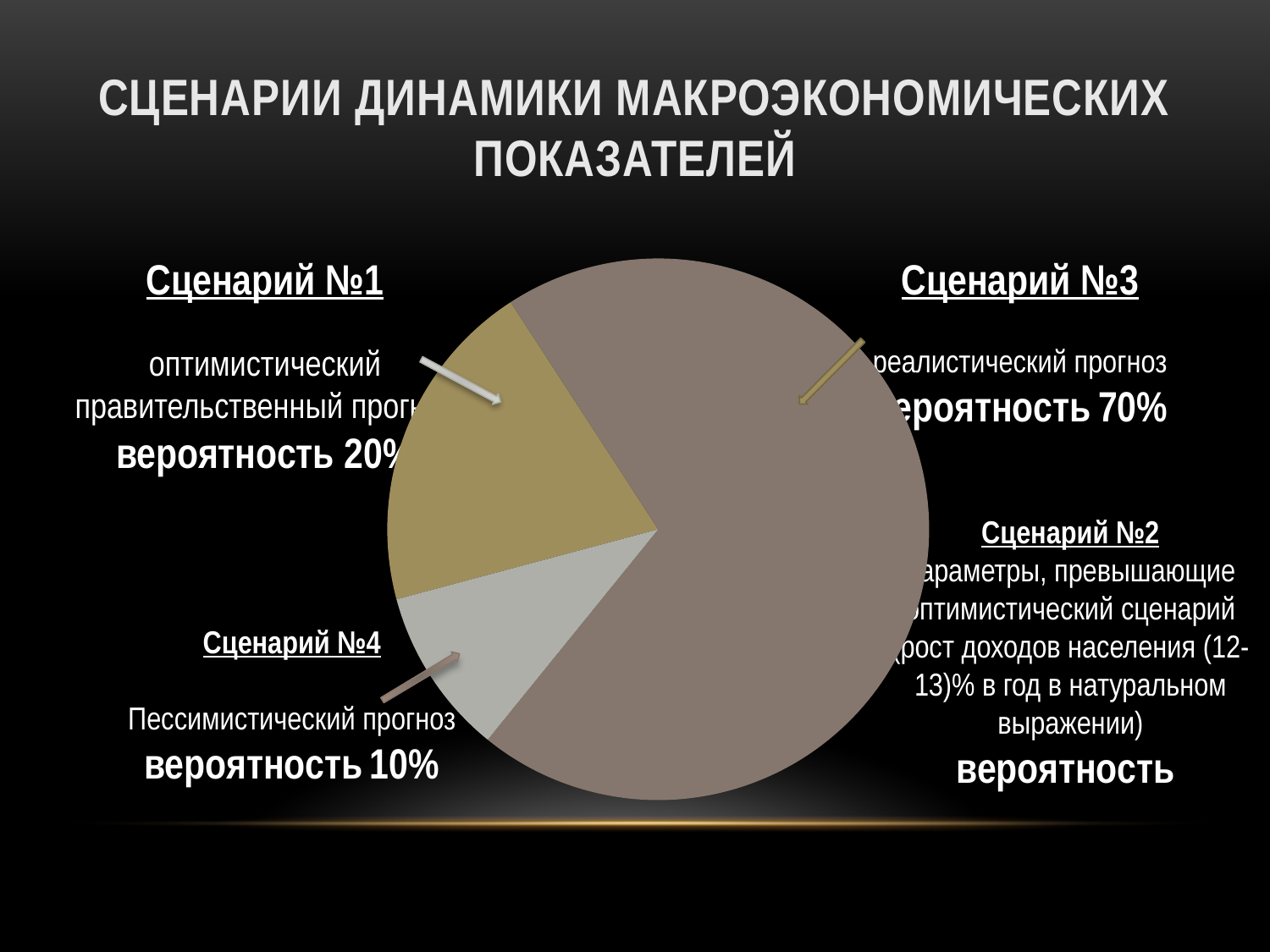
What is the title of the slide containing the pie chart? Сценарии динамики макроэкономических показателей What is the difference in probability between Сценарий №1 and Сценарий №4? 10 percentage points What probability is given for Сценарий №1 (оптимистический правительственный прогноз)? 20% What share of the pie does the реалистический прогноз (Сценарий №3) take? 70% What is the difference in probability between Сценарий №3 and Сценарий №1? 50 percentage points What probability is given for Сценарий №3 (реалистический прогноз)? 70% Which has the larger slice, Сценарий №1 or Сценарий №4? Сценарий №1 What kind of chart is shown on the slide? pie chart Which scenario with a printed probability has the smallest slice of the pie? Сценарий №4 Which scenario has the largest slice of the pie? Сценарий №3 What probability is given for Сценарий №4 (пессимистический прогноз)? 10% How many distinct slices are visible in the pie chart? 3